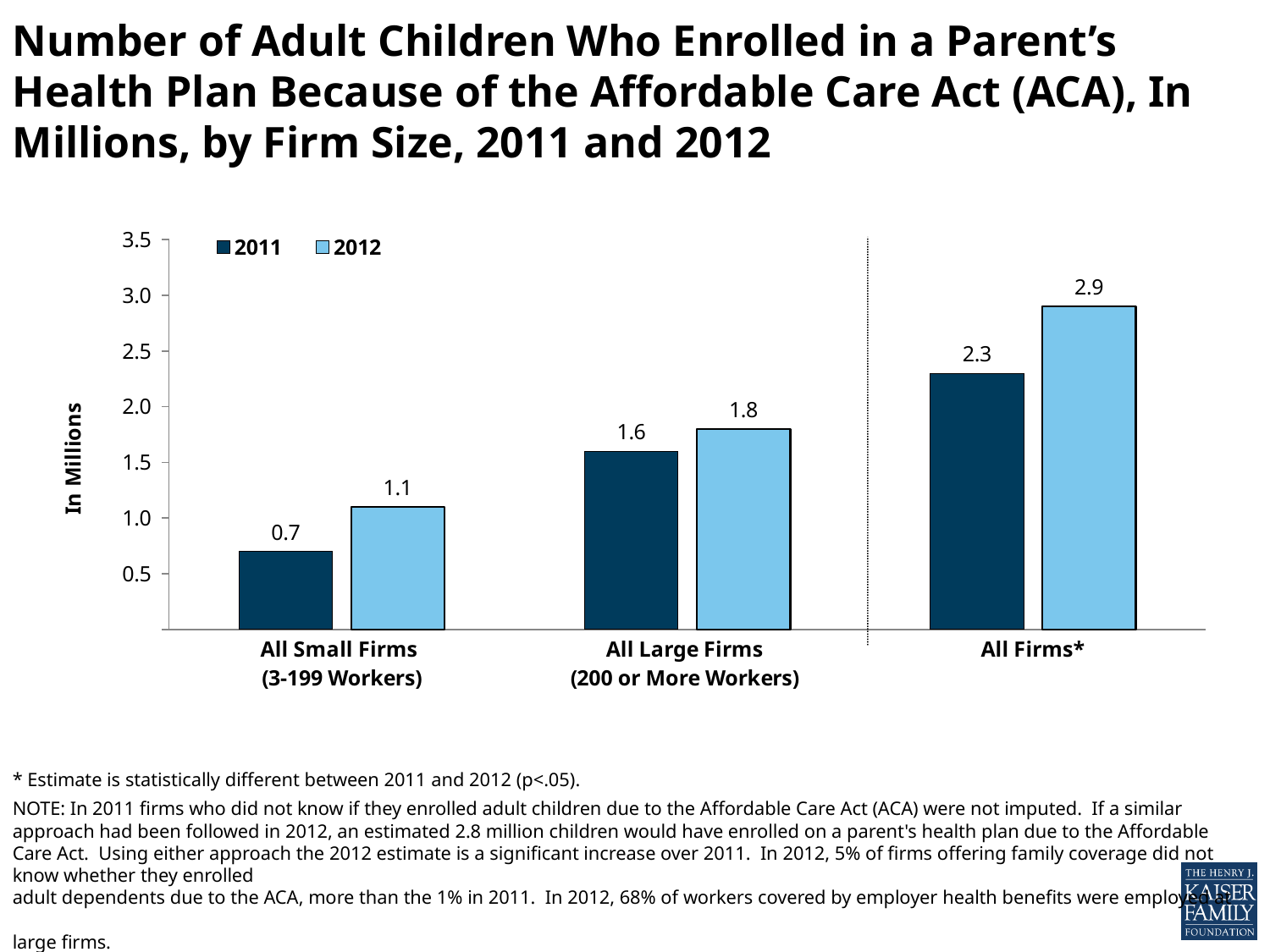
What is the 2012 value for All Firms*? 2.9 Which category has the lowest 2011 value? All Small Firms (3-199 Workers) What is the difference between the 2012 and 2011 values for All Small Firms (3-199 Workers)? 0.4 What is the 2011 value for All Small Firms (3-199 Workers)? 0.7 Which is larger: the 2011 value for All Large Firms (200 or More Workers) or the 2012 value for All Small Firms (3-199 Workers)? 2011 value for All Large Firms (200 or More Workers) Is the 2011 value for All Firms* greater or less than 2.0? greater What is the 2012 value for All Large Firms (200 or More Workers)? 1.8 What kind of chart is shown on the slide? bar chart How many series does the legend list? 2 How many firm-size categories are shown on the x axis? 3 What is the difference between the 2012 and 2011 values for All Firms*? 0.6 Which category has the highest 2012 value? All Firms*